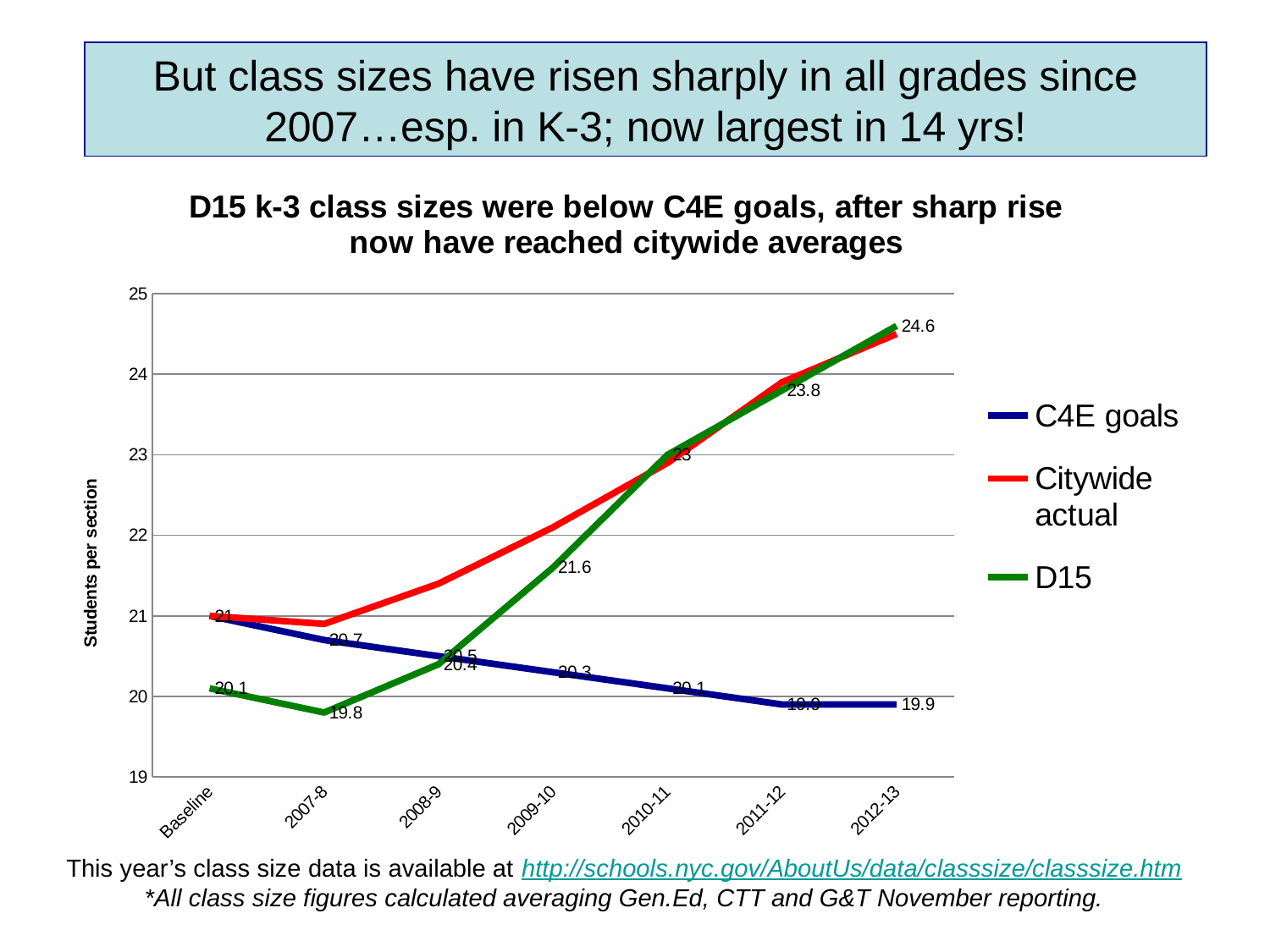
In which year is the D15 value lowest? 2007-8 What is the difference between the D15 values for 2012-13 and 2007-8? 4.8 How many points are plotted along the x axis for each series? 7 What is the C4E goals value for 2012-13? 19.9 Do the C4E goals values rise or fall from Baseline to 2012-13? fall What kind of chart is shown on the slide? line chart Is the Citywide actual value for 2011-12 greater or less than 23? greater How many series does the legend list? 3 What is the D15 value for 2007-8? 19.8 What is the D15 value for 2010-11? 23 In which year is the D15 value highest? 2012-13 What is the D15 value for 2012-13? 24.6